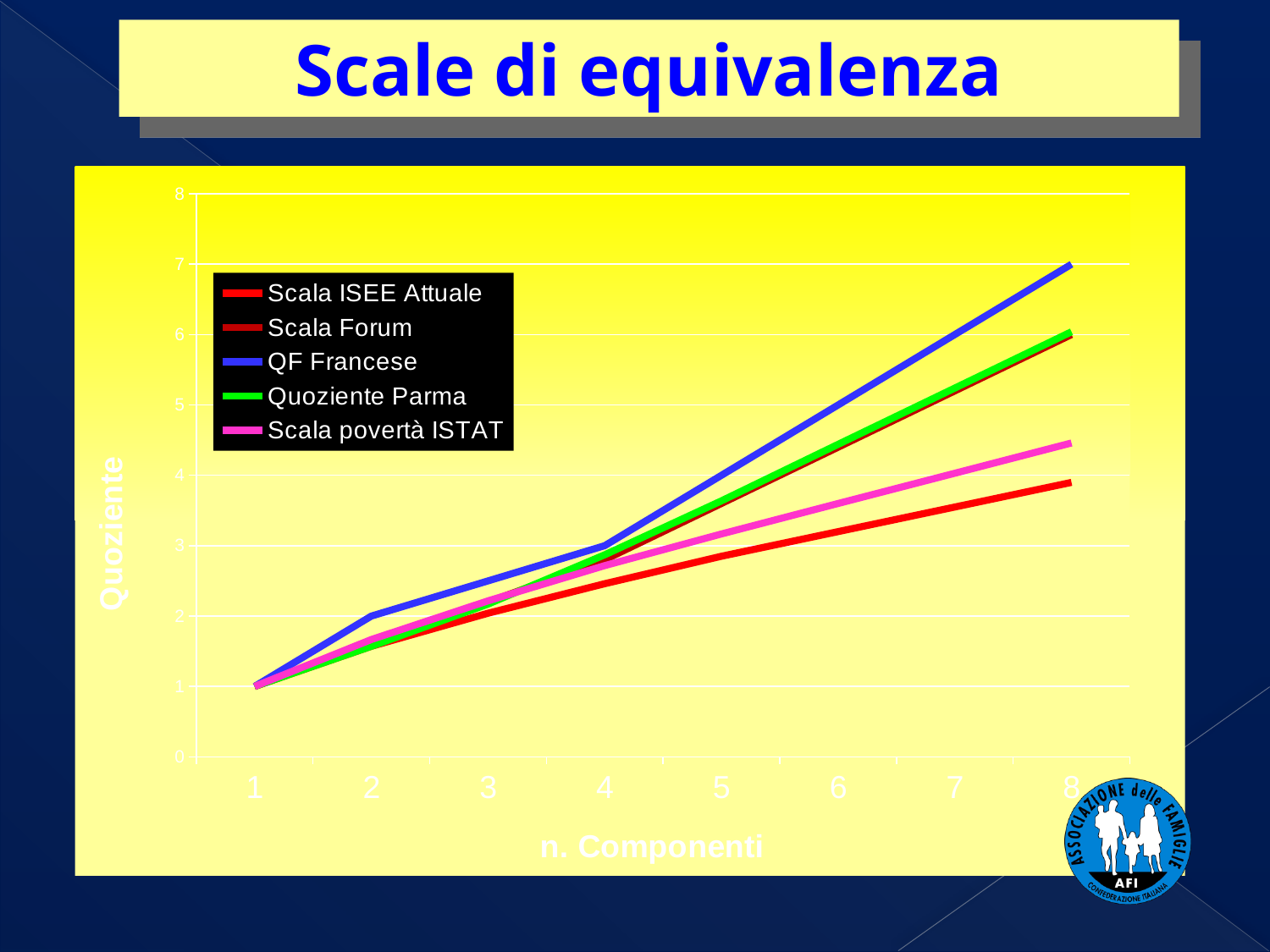
Is the Quoziente for Scala povertà ISTAT at 8 components greater or less than 4? greater How many values of n. Componenti are shown on the x axis? 8 At 8 components, which is larger: QF Francese or Scala povertà ISTAT? QF Francese Which series has the highest Quoziente at 8 components? QF Francese Do the Quoziente values rise or fall as n. Componenti increases? rise What kind of chart is shown on the slide? line chart What is the Quoziente for QF Francese at 8 components? 7 What is the title of the chart? Scale di equivalenza Which series has the lowest Quoziente at 8 components? Scala ISEE Attuale How many series does the legend list? 5 What is the Quoziente for all series at 1 component? 1